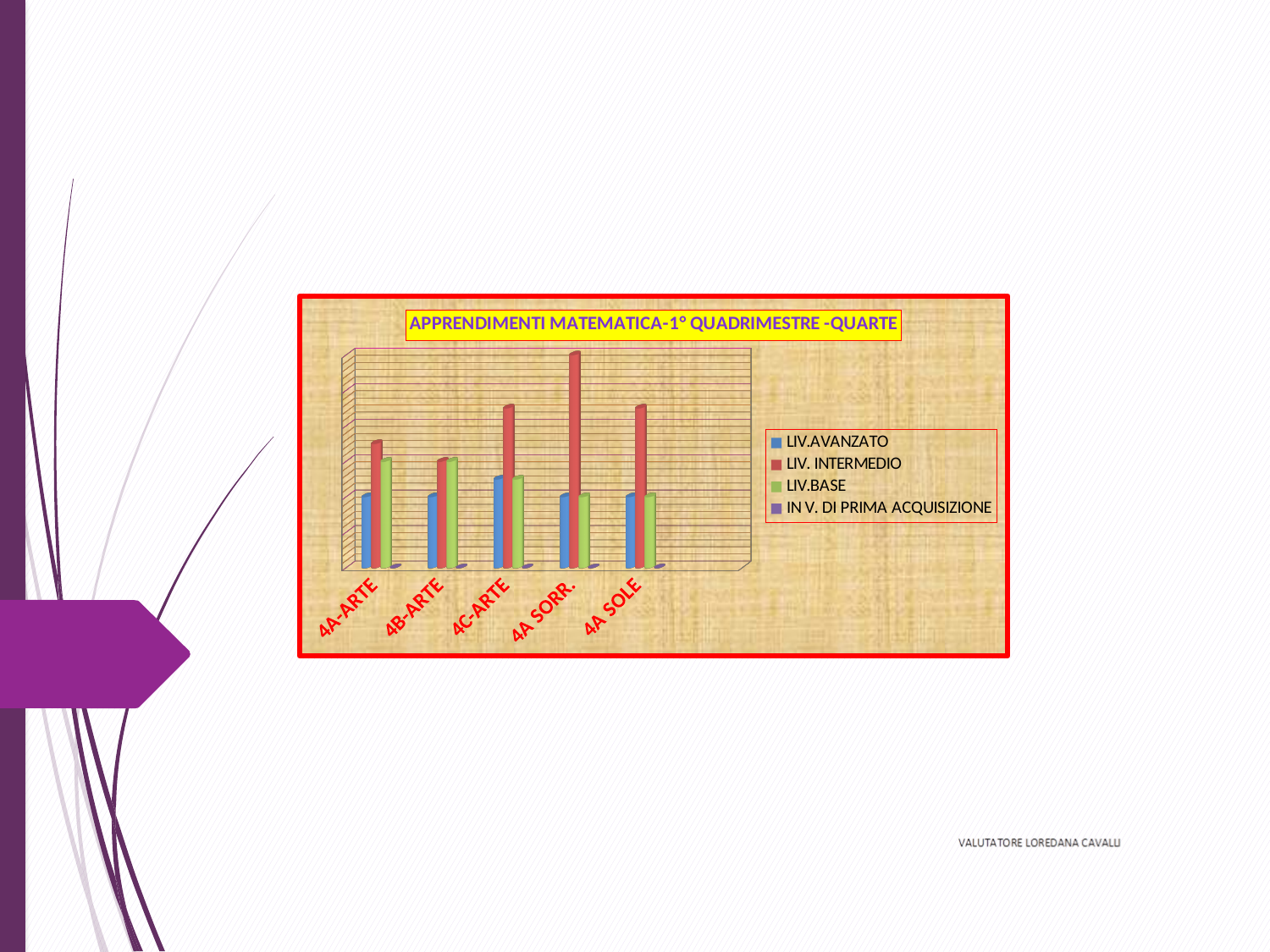
How many classes (categories) are shown on the x axis of the chart? 5 What kind of chart is shown on the slide? bar chart For 4A SOLE, is the LIV. INTERMEDIO bar or the LIV.AVANZATO bar larger? LIV. INTERMEDIO How many series does the chart legend list? 4 Is the LIV. INTERMEDIO bar larger for 4A SORR. or for 4A-ARTE? 4A SORR. What is the title of the chart? APPRENDIMENTI MATEMATICA-1° QUADRIMESTRE -QUARTE Which class has the highest LIV.AVANZATO bar? 4C-ARTE For 4A-ARTE, is the LIV.BASE bar or the LIV.AVANZATO bar larger? LIV.BASE Which class has the highest LIV. INTERMEDIO bar? 4A SORR. Which series is shown in red in the chart? LIV. INTERMEDIO